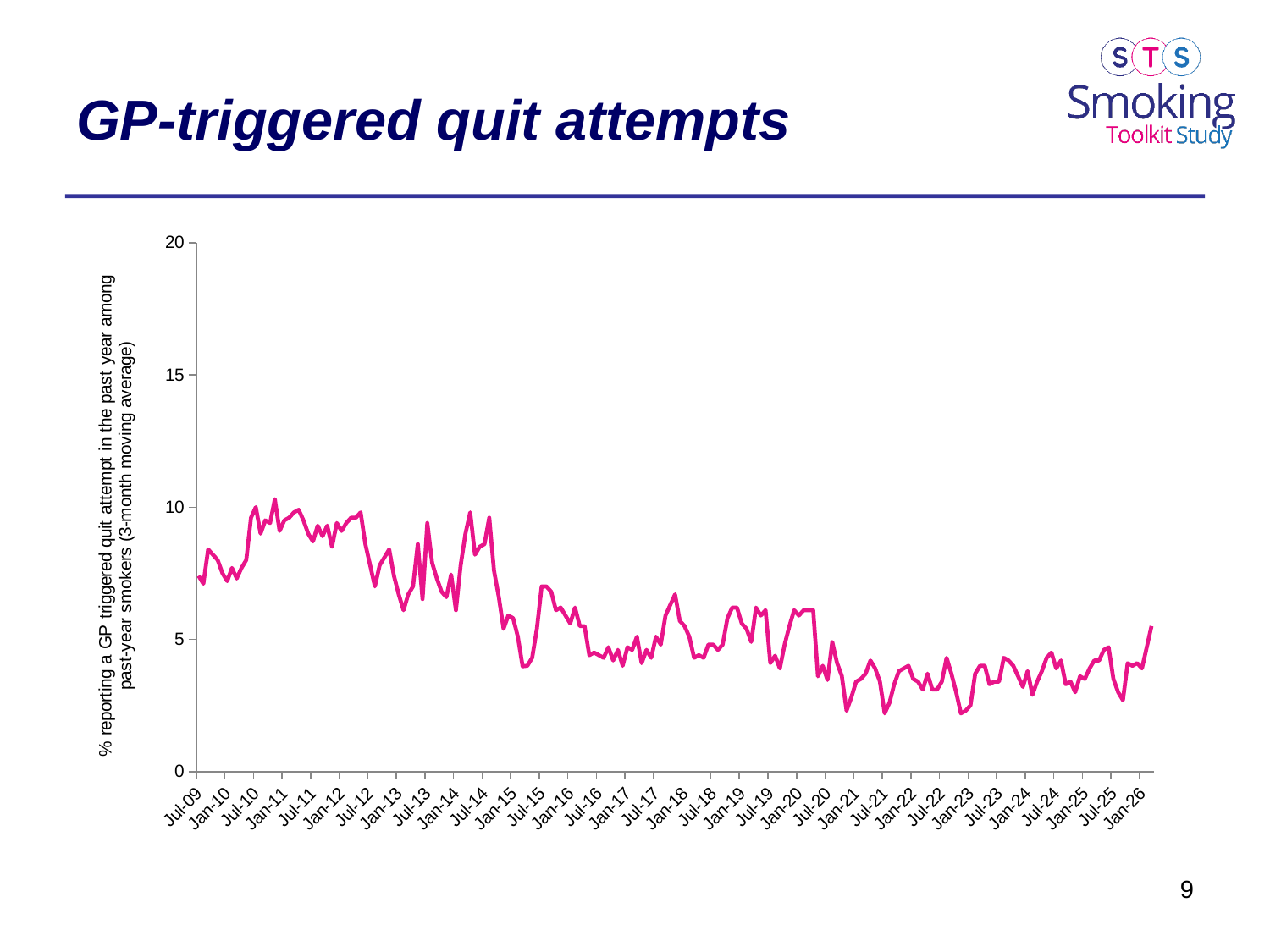
Is the value for Jan-21 greater or less than 5? less Which is larger, the value for Jan-11 or the value for Jan-21? Jan-11 What is the title of the slide's chart? GP-triggered quit attempts Which is larger, the value for Jul-10 or the value for Jul-22? Jul-10 Is the highest value on the chart greater or less than 15? less Is the value for Jul-10 greater or less than 5? greater What kind of chart is shown on the slide? line chart How many lines (series) are plotted on the chart? 1 Overall, do the values rise or fall from Jul-09 to Jan-26? fall What is the highest tick value shown on the y axis? 20